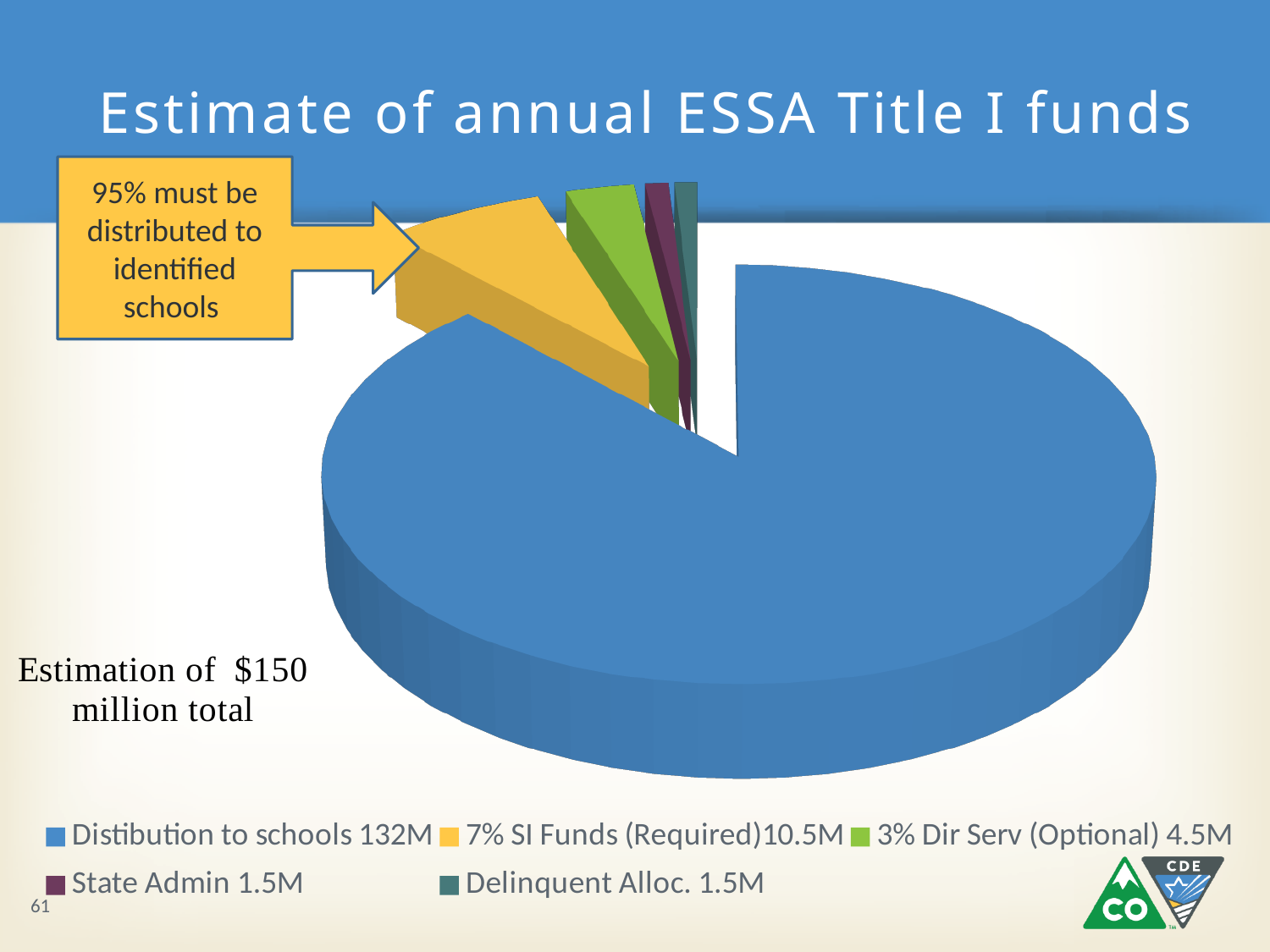
What is the title of the chart slide? Estimate of annual ESSA Title I funds What value is shown for Distribution to schools? 132M What value is shown for State Admin? 1.5M What is the difference between the 7% SI Funds (Required) value and the 3% Dir Serv (Optional) value? 6M What colour is the Distribution to schools slice? Blue Which is larger, 7% SI Funds (Required) or 3% Dir Serv (Optional)? 7% SI Funds (Required) How many slices does the pie chart have? 5 What is the estimated total amount represented by the pie chart? $150 million What value is shown for 3% Dir Serv (Optional)? 4.5M What kind of chart is shown on the slide? Pie chart What value is shown for 7% SI Funds (Required)? 10.5M Which category has the largest slice of the pie? Distribution to schools